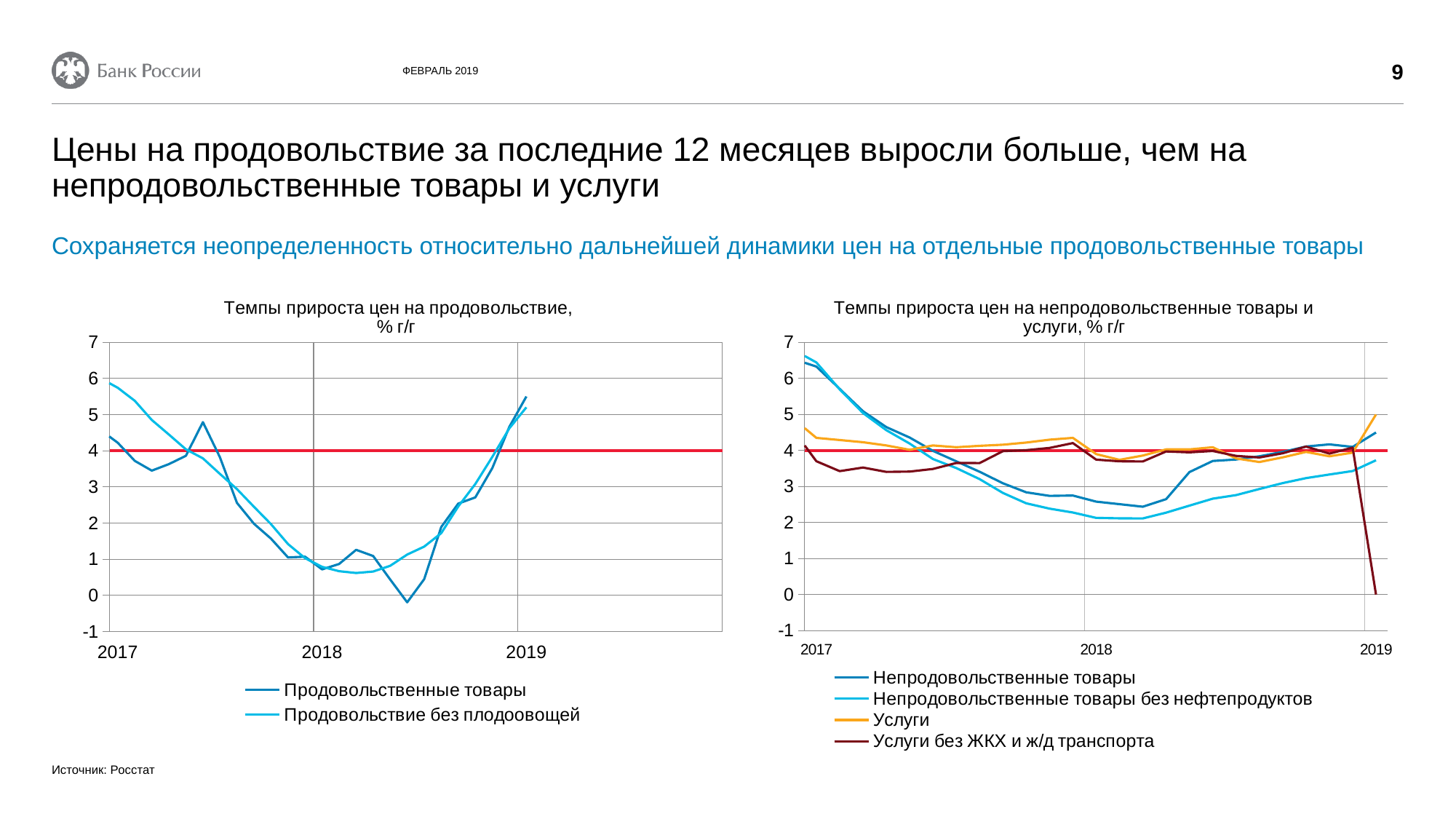
In the right chart, 'Темпы прироста цен на непродовольственные товары и услуги, % г/г', which series is drawn in orange? Услуги In the right chart, 'Темпы прироста цен на непродовольственные товары и услуги, % г/г', is the value for 'Непродовольственные товары' at the 2017 tick greater or less than 6? greater In the left chart, 'Темпы прироста цен на продовольствие, % г/г', does the 'Продовольственные товары' line rise or fall between the 2018 and 2019 ticks? rise What is the title of the left chart on the slide? Темпы прироста цен на продовольствие, % г/г How many series does the legend of the left chart, 'Темпы прироста цен на продовольствие, % г/г', list? 2 In the left chart, 'Темпы прироста цен на продовольствие, % г/г', is the value for 'Продовольственные товары' at the 2019 tick greater or less than 4? greater In the left chart, 'Темпы прироста цен на продовольствие, % г/г', is the value for 'Продовольственные товары' at the 2018 tick greater or less than 2? less What kind of chart is the left chart, 'Темпы прироста цен на продовольствие, % г/г'? line chart How many series does the legend of the right chart, 'Темпы прироста цен на непродовольственные товары и услуги, % г/г', list? 4 In the right chart, 'Темпы прироста цен на непродовольственные товары и услуги, % г/г', does the 'Непродовольственные товары' line rise or fall between the 2017 and 2018 ticks? fall